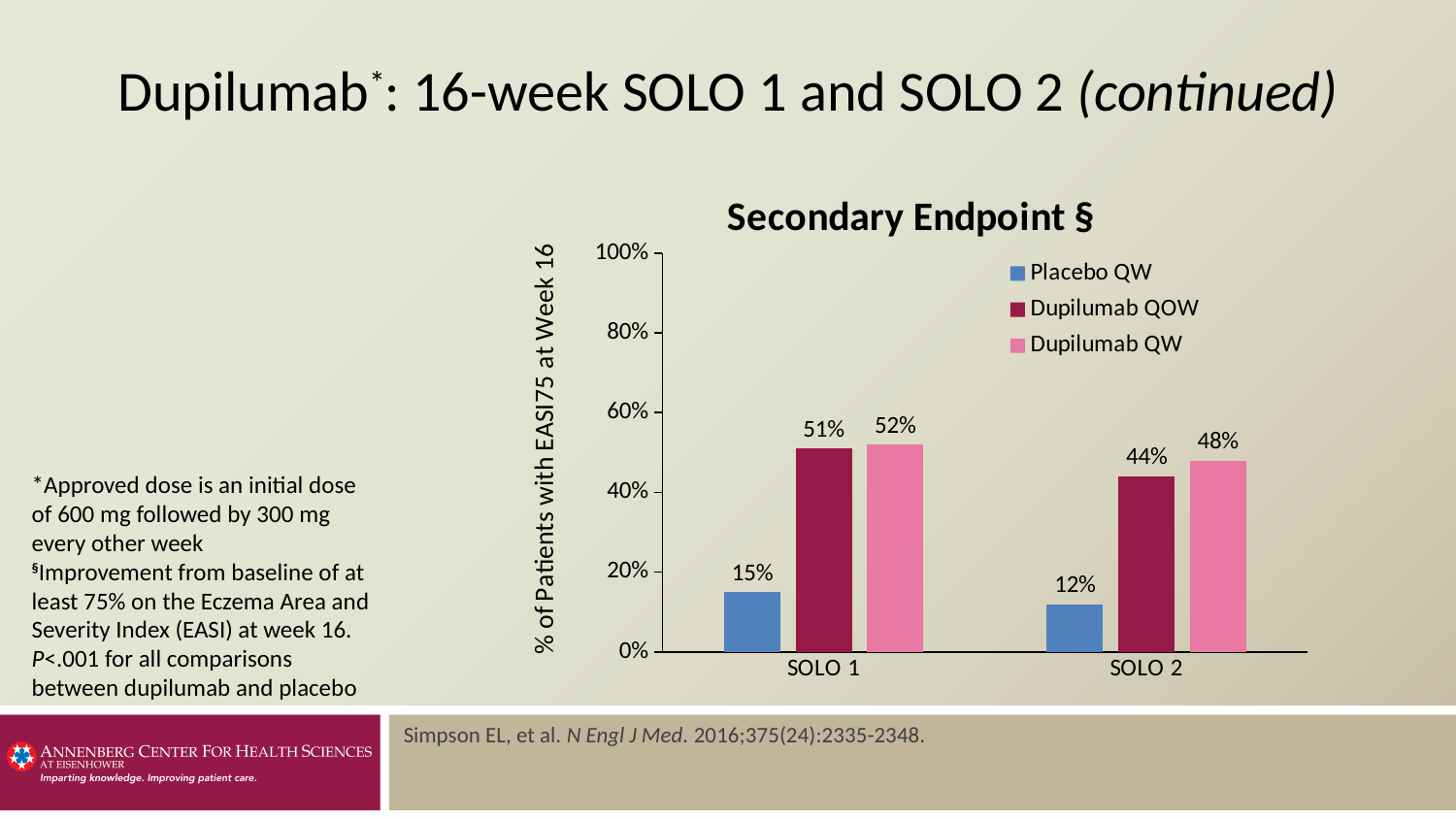
What is the title of the chart? Secondary Endpoint § How many series does the legend list? 3 What kind of chart is shown on the slide? Bar chart What percentage of patients achieved EASI75 at week 16 with Placebo QW in SOLO 1? 15% What is the value for Dupilumab QOW in SOLO 2? 44% What is the difference between Dupilumab QOW and Placebo QW in SOLO 1? 36% Which series has the highest value in SOLO 2? Dupilumab QW What is the value for Dupilumab QW in SOLO 1? 52% What is the difference between Dupilumab QW in SOLO 1 and Dupilumab QW in SOLO 2? 4% Which is larger: Placebo QW in SOLO 1 or Placebo QW in SOLO 2? Placebo QW in SOLO 1 Is the value for Dupilumab QOW in SOLO 2 greater or less than 40%? greater Which series has the lowest value in SOLO 1? Placebo QW